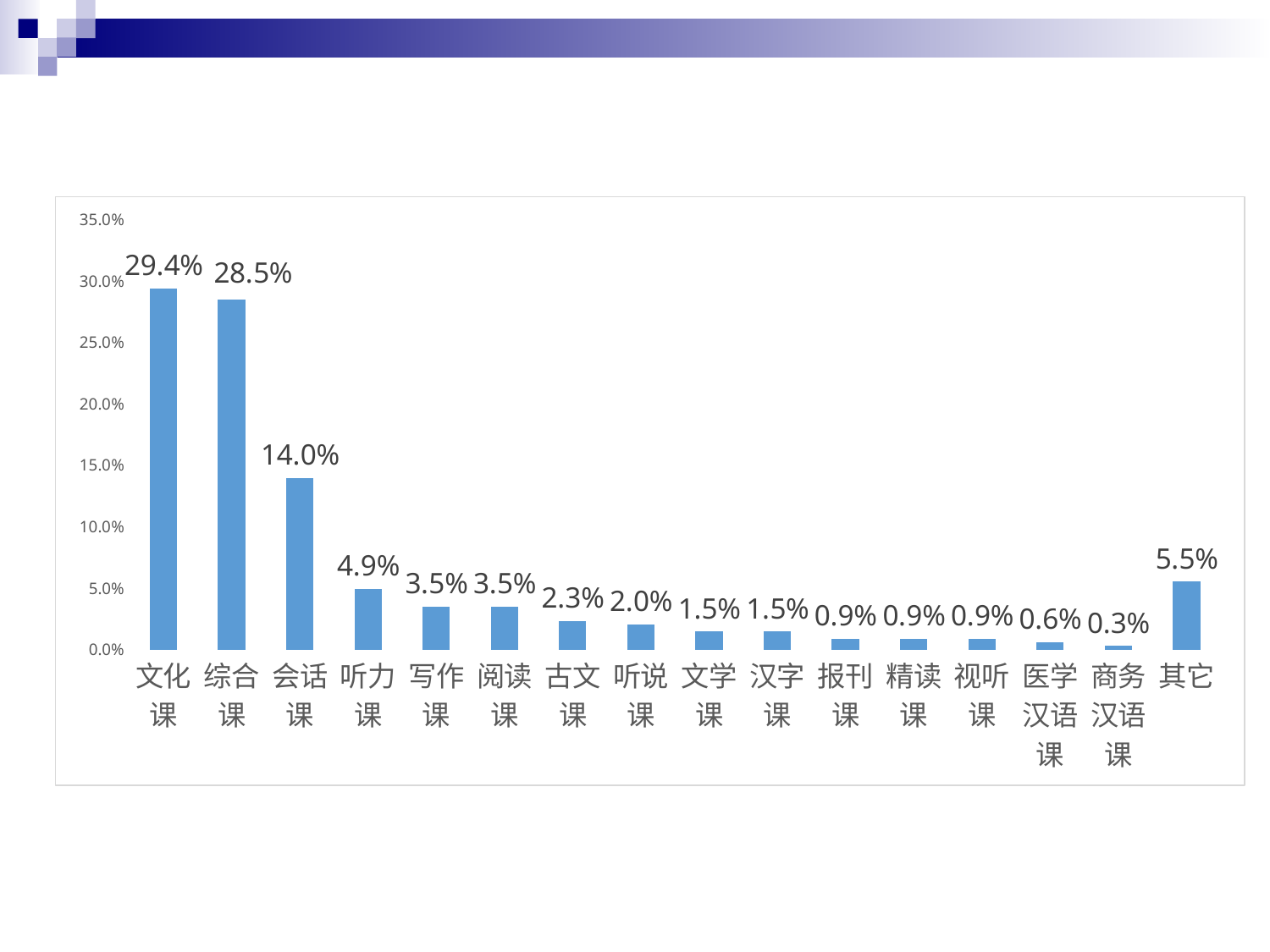
What is the difference between the values for 文化课 and 综合课? 0.9% What is the value for 文化课? 29.4% How many categories are shown on the x axis? 16 What is the value for 其它? 5.5% What is the value for 会话课? 14.0% What kind of chart is shown on the slide? bar chart What is the difference between the values for 会话课 and 听力课? 9.1% Which is larger, the value for 其它 or the value for 听力课? 其它 Which category has the lowest value? 商务汉语课 Which category has the highest value? 文化课 What is the value for 商务汉语课? 0.3% Is the value for 综合课 greater or less than 25.0%? greater